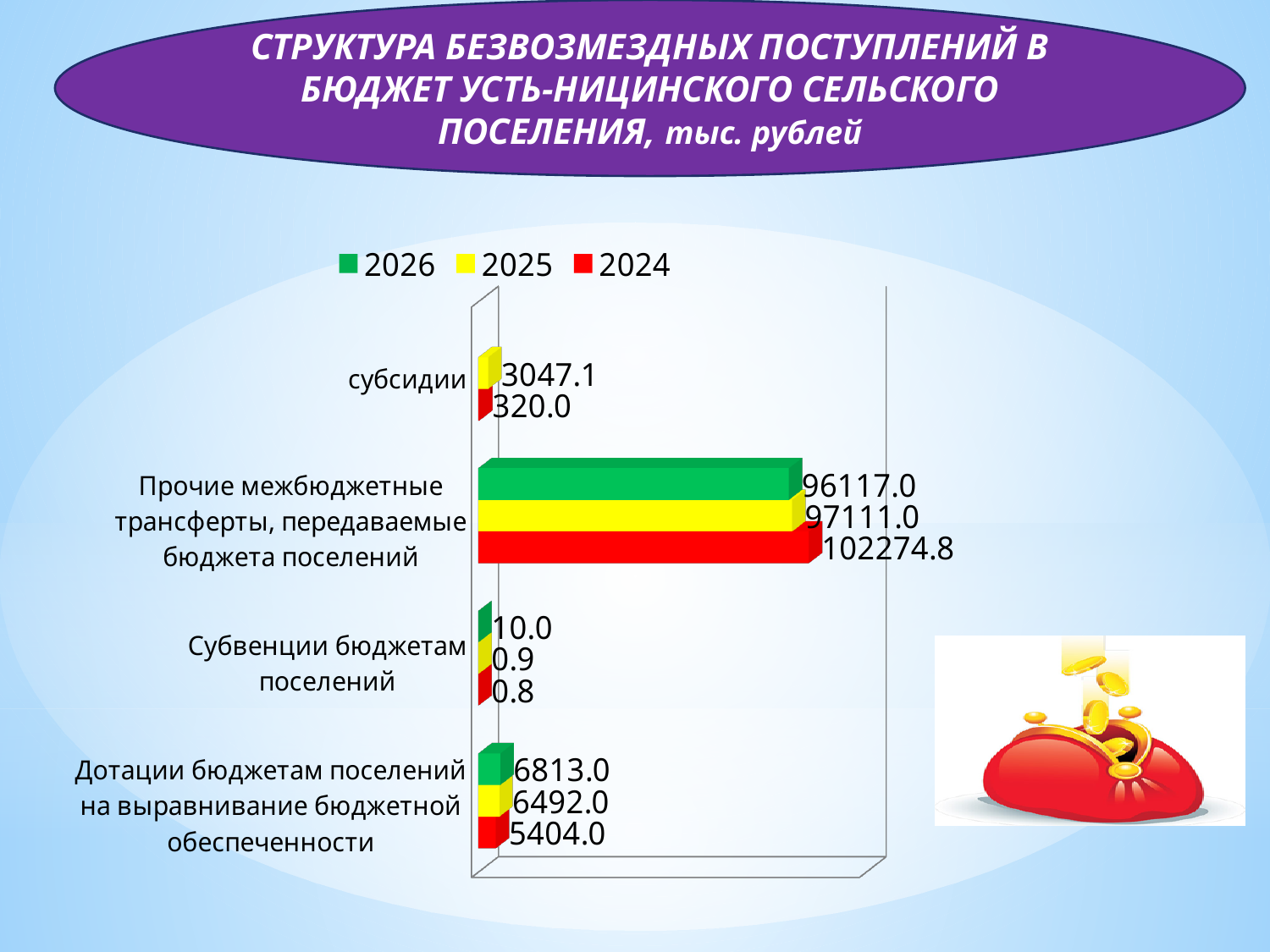
How many categories are shown on the chart? 4 What is the value for 2024 in the category "Прочие межбюджетные трансферты, передаваемые бюджета поселений"? 102274.8 What is the value for 2026 in the category "Субвенции бюджетам поселений"? 10.0 What is the value for 2025 in the category "субсидии"? 3047.1 What is the difference between the 2025 and 2024 values for "Дотации бюджетам поселений на выравнивание бюджетной обеспеченности"? 1088.0 What kind of chart is shown on the slide? Bar chart What is the value for 2026 in the category "Дотации бюджетам поселений на выравнивание бюджетной обеспеченности"? 6813.0 Which category has the lowest value for 2024? Субвенции бюджетам поселений Which is larger for "Прочие межбюджетные трансферты, передаваемые бюджета поселений": the 2026 value or the 2025 value? 2025 How many series does the legend list? 3 Which colour represents the 2024 series in the legend? Red Which category has the highest value for 2025? Прочие межбюджетные трансферты, передаваемые бюджета поселений